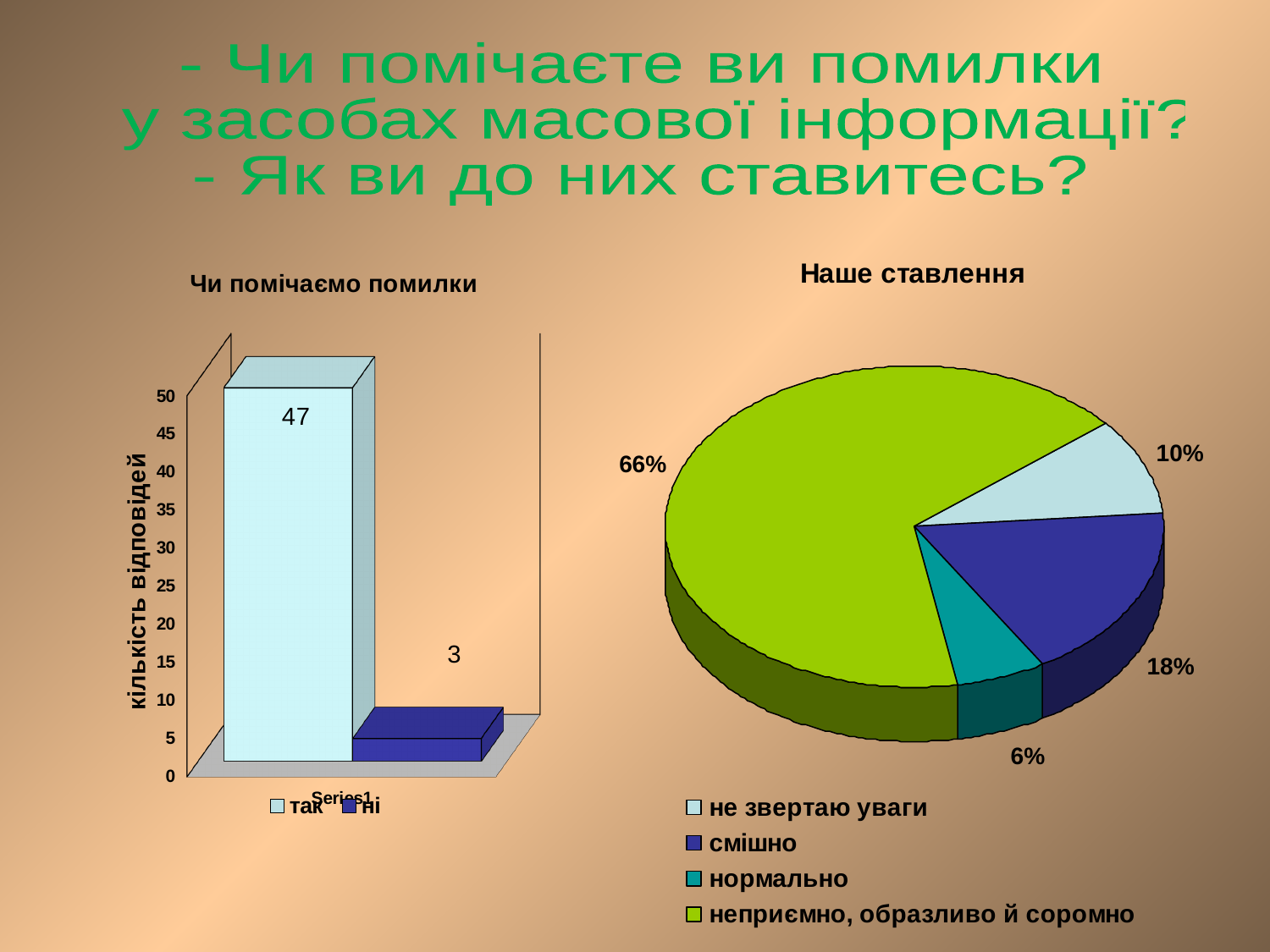
In the chart titled "Наше ставлення", what share does "смішно" have? 18% In the chart titled "Чи помічаємо помилки", what is the difference between the values for "так" and "ні"? 44 In the chart titled "Чи помічаємо помилки", what is the value for "так"? 47 In the chart titled "Чи помічаємо помилки", which category has the higher value, "так" or "ні"? так What kind of chart is the chart titled "Наше ставлення"? pie chart What kind of chart is the chart titled "Чи помічаємо помилки"? bar chart In the chart titled "Наше ставлення", how many categories does the legend list? 4 In the chart titled "Чи помічаємо помилки", what is the value for "ні"? 3 In the chart titled "Наше ставлення", what share does "неприємно, образливо й соромно" have? 66% In the chart titled "Чи помічаємо помилки", what is the label of the vertical axis? кількість відповідей In the chart titled "Наше ставлення", what share does "не звертаю уваги" have? 10% In the chart titled "Наше ставлення", which category has the smallest share? нормально